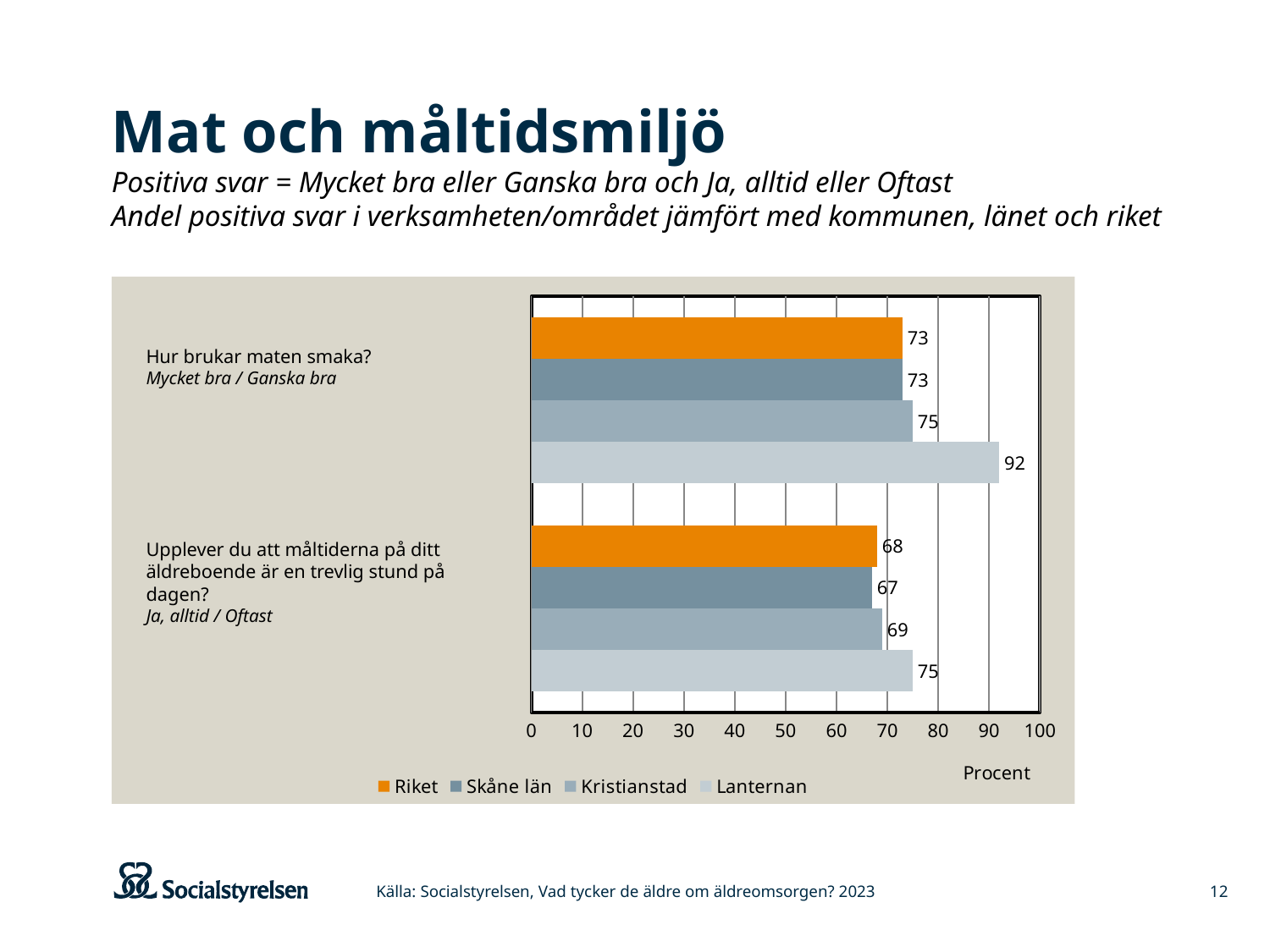
What kind of chart is shown on the slide? Bar chart Which series has the lowest value on the question "Upplever du att måltiderna på ditt äldreboende är en trevlig stund på dagen?"? Skåne län What is the difference between Lanternan and Kristianstad on the question "Upplever du att måltiderna på ditt äldreboende är en trevlig stund på dagen?"? 6 What is the value for Skåne län on the question "Upplever du att måltiderna på ditt äldreboende är en trevlig stund på dagen?"? 67 What is the value for Kristianstad on the question "Hur brukar maten smaka?"? 75 Which is larger for Lanternan: the value for "Hur brukar maten smaka?" or the value for "Upplever du att måltiderna på ditt äldreboende är en trevlig stund på dagen?"? Hur brukar maten smaka? What is the difference between Lanternan and Riket on the question "Hur brukar maten smaka?"? 19 What is the value for Lanternan on the question "Hur brukar maten smaka?"? 92 What is the label of the x axis? Procent How many series does the legend list? 4 Which series has the highest value on the question "Hur brukar maten smaka?"? Lanternan What is the value for Riket on the question "Upplever du att måltiderna på ditt äldreboende är en trevlig stund på dagen?"? 68